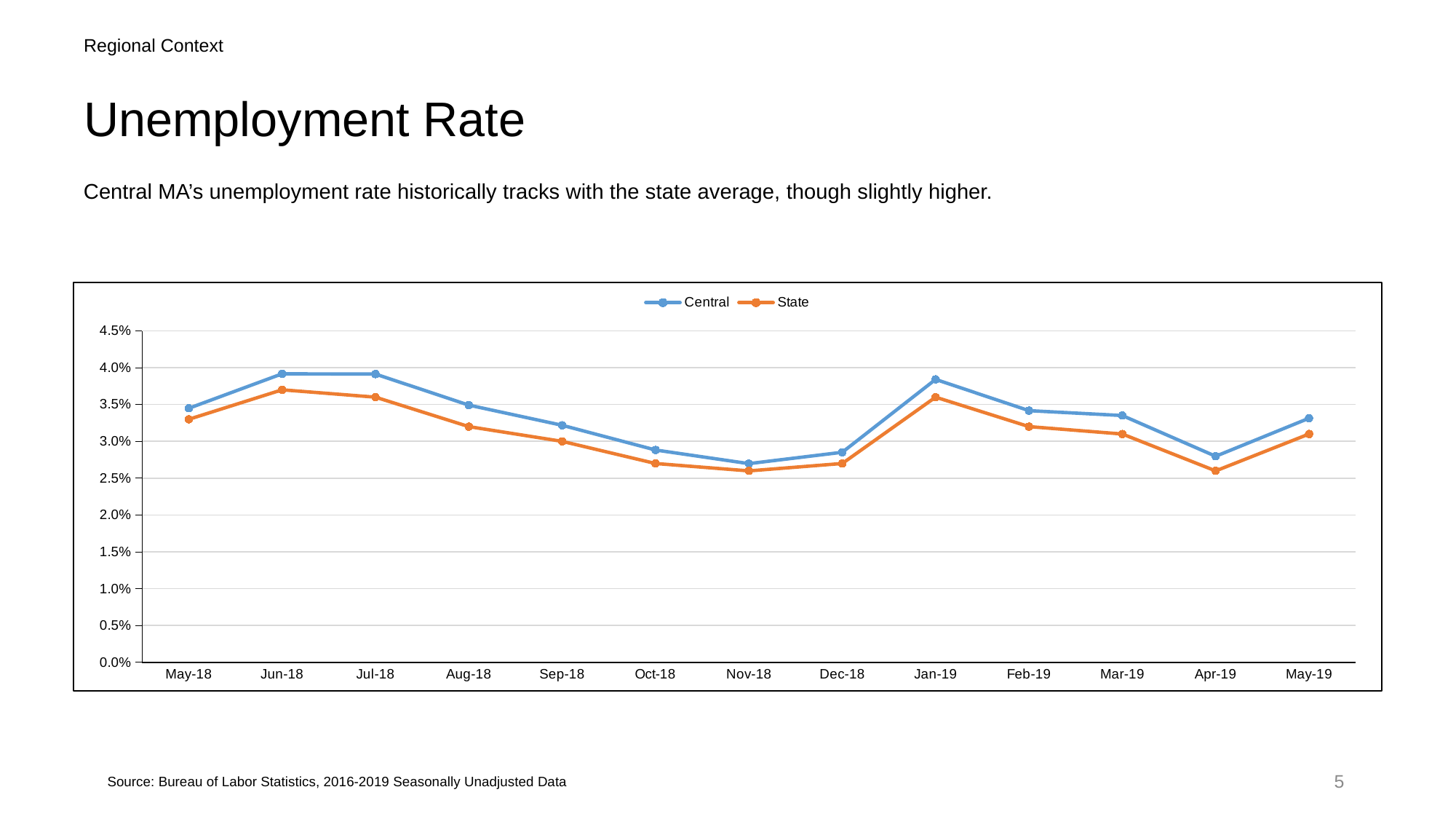
Which series is drawn in orange? State Is the State value for Nov-18 greater or less than 3.0%? less How many series does the legend list? 2 Does the Central series rise or fall from Jul-18 to Nov-18? Fall What are the two series named in the legend? Central and State What kind of chart is shown on the slide? Line chart In Jan-19, which series has the higher value, Central or State? Central For the Central series, which is higher, Jun-18 or Nov-18? Jun-18 Is the Central value for Jun-18 greater or less than 3.5%? greater Is the State value for Apr-19 greater or less than 3.0%? less How many months are plotted along the x axis? 13